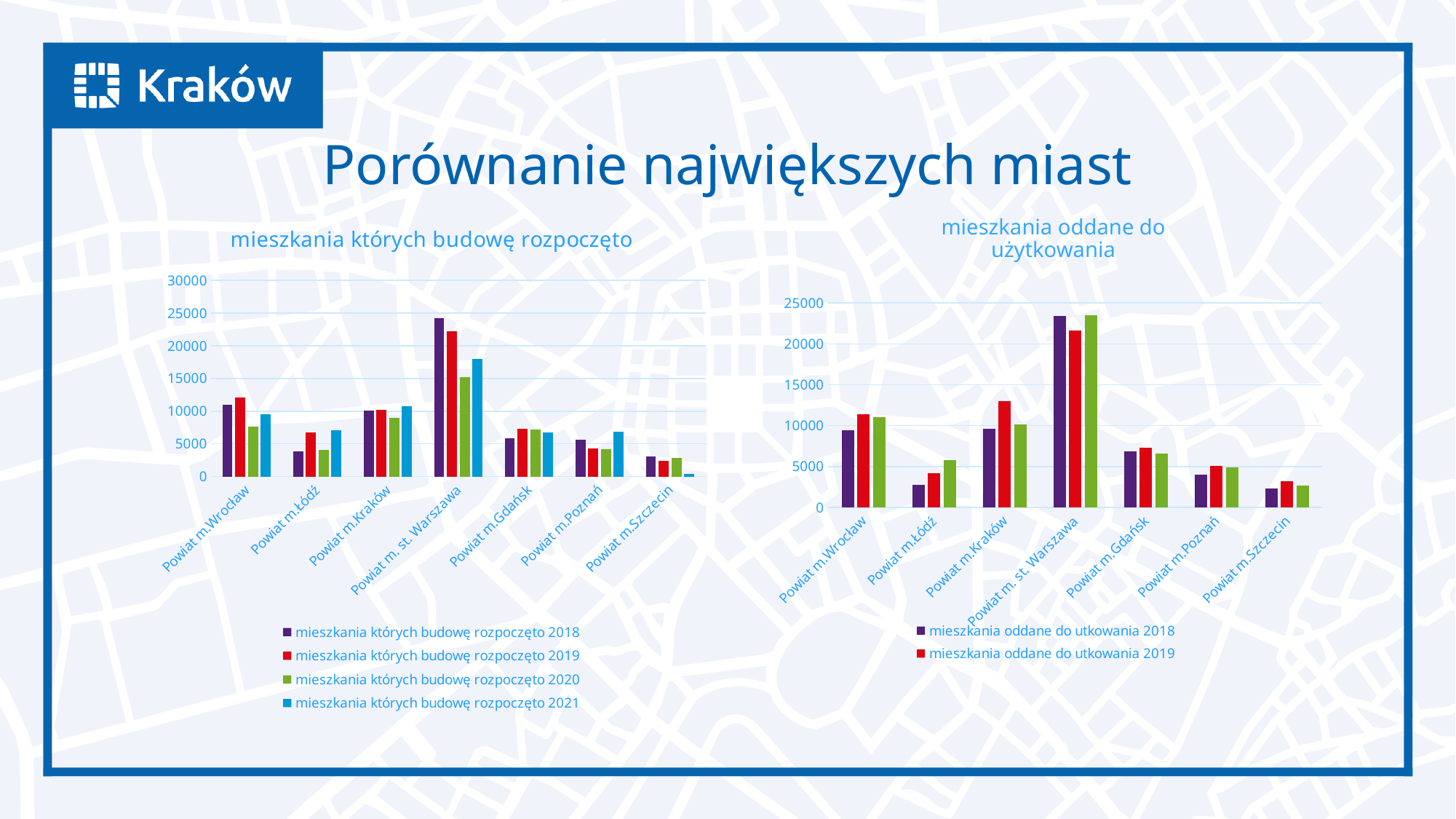
How many series does the legend of the left chart "mieszkania których budowę rozpoczęto" list? 4 In the right chart "mieszkania oddane do użytkowania", is the 2019 value for Powiat m.Kraków greater or less than 10000? greater In the left chart "mieszkania których budowę rozpoczęto", which is larger for 2019: Powiat m.Wrocław or Powiat m.Łódź? Powiat m.Wrocław In the right chart "mieszkania oddane do użytkowania", which is larger for 2019: Powiat m.Kraków or Powiat m.Gdańsk? Powiat m.Kraków In the left chart "mieszkania których budowę rozpoczęto", is the 2018 value for Powiat m.Łódź greater or less than 5000? less What type of chart is the left chart titled "mieszkania których budowę rozpoczęto"? bar chart In the left chart "mieszkania których budowę rozpoczęto", which category has the highest value for 2018? Powiat m. st. Warszawa How many categories (powiaty) are shown on the x axis of the left chart "mieszkania których budowę rozpoczęto"? 7 In the right chart "mieszkania oddane do użytkowania", which category has the highest value for 2018? Powiat m. st. Warszawa In the left chart "mieszkania których budowę rozpoczęto", which category has the lowest value for 2021? Powiat m.Szczecin How many series does the legend of the right chart "mieszkania oddane do użytkowania" list? 2 In the left chart "mieszkania których budowę rozpoczęto", is the 2018 value for Powiat m. st. Warszawa greater or less than 20000? greater